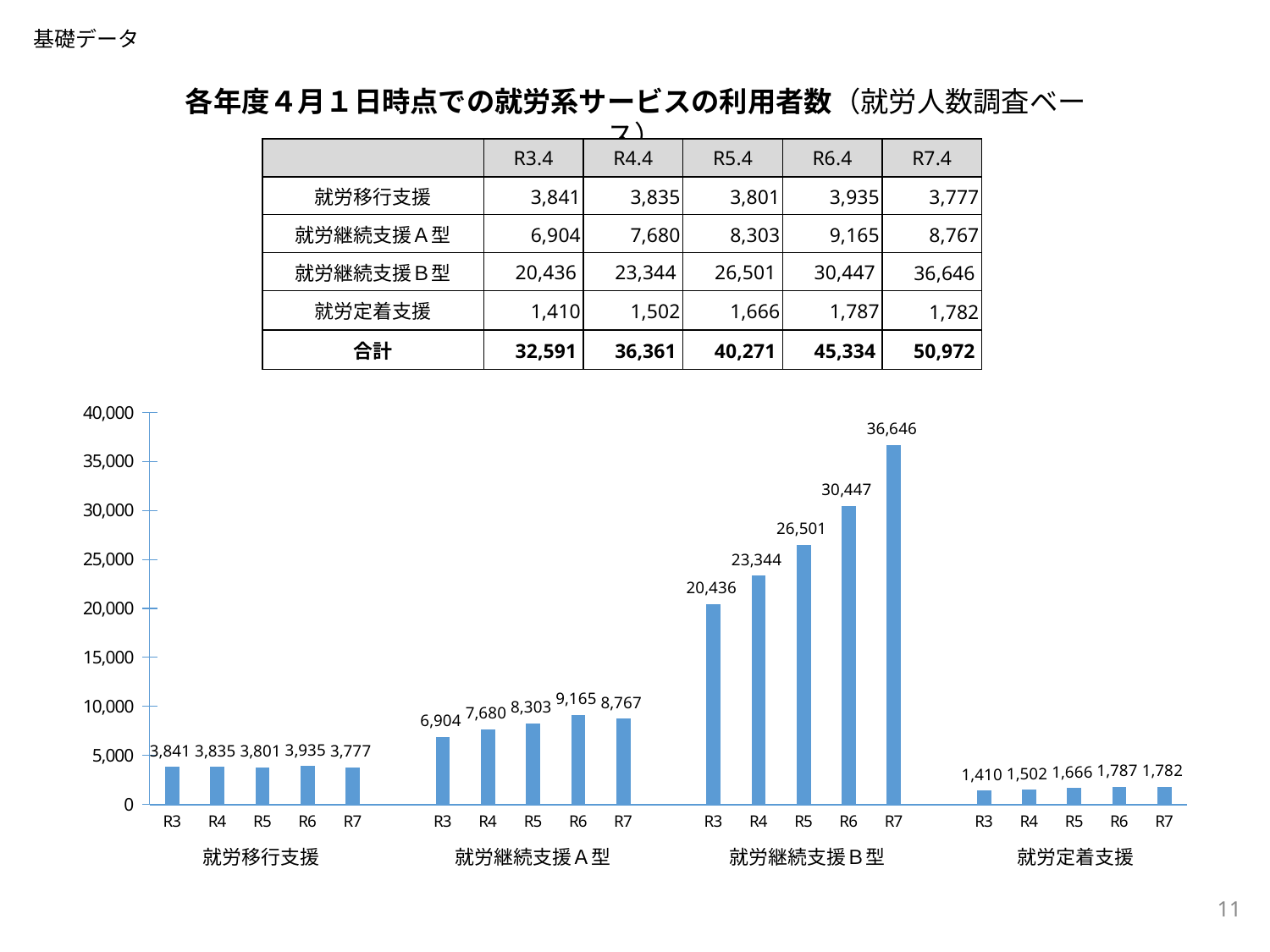
What is the difference between the R7 and R3 values in the 就労継続支援Ｂ型 group? 16,210 What is the value for R6 in the 就労移行支援 group? 3,935 What kind of chart is shown on the slide? bar chart Is the R6 value in the 就労継続支援Ｂ型 group greater or less than 30,000? greater Which bar in the 就労継続支援Ａ型 group is the highest? R6 What is the value for R7 in the 就労継続支援Ｂ型 group? 36,646 Which bar in the 就労定着支援 group is the lowest? R3 Which is larger: the R7 value for 就労継続支援Ａ型 or the R6 value for 就労継続支援Ａ型? R6 value for 就労継続支援Ａ型 Do the values in the 就労継続支援Ｂ型 group rise or fall from R3 to R7? rise What is the value for R3 in the 就労定着支援 group? 1,410 How many bars are plotted in the 就労継続支援Ｂ型 group? 5 What is the value for R5 in the 就労継続支援Ａ型 group? 8,303